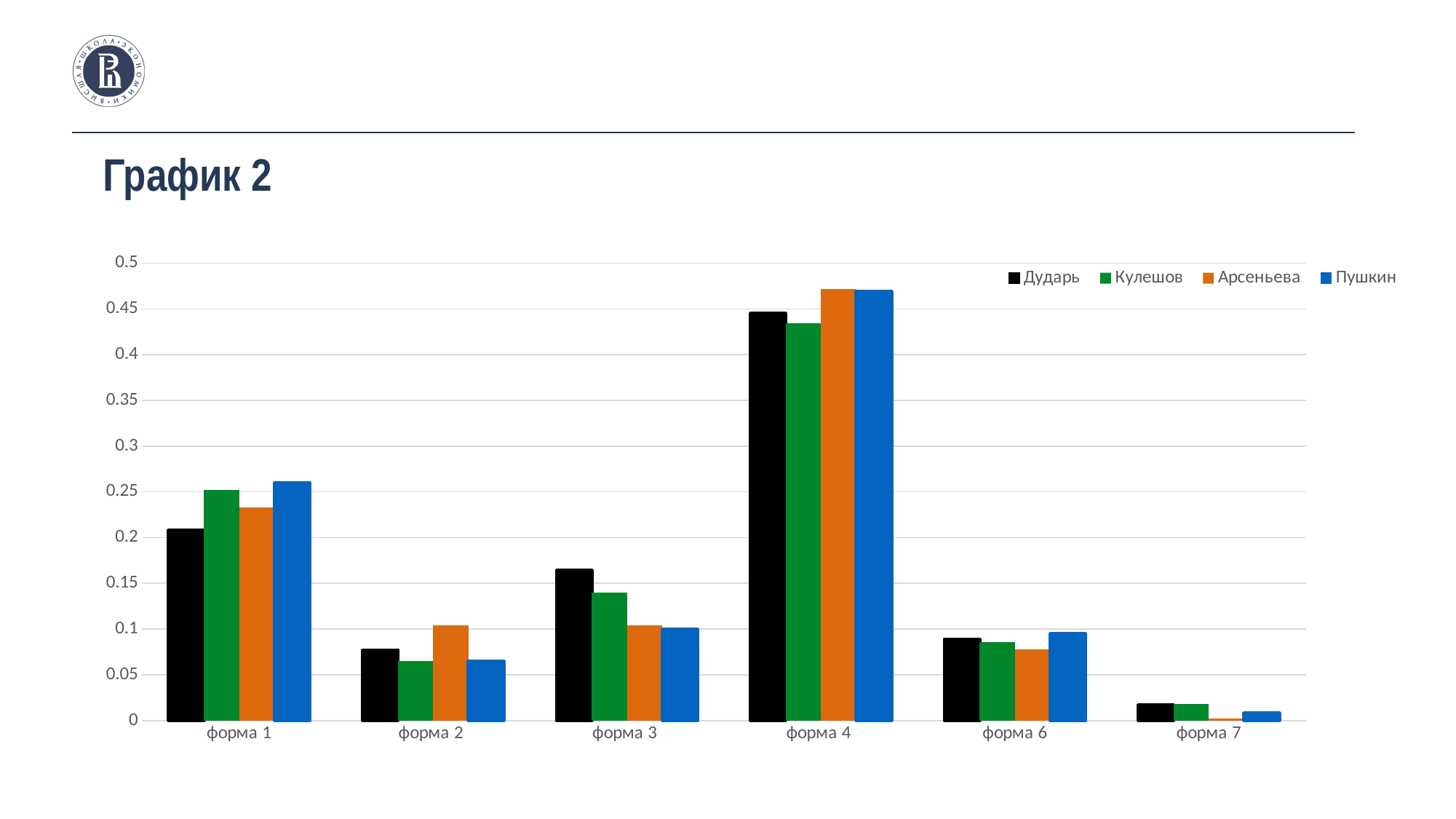
Which category has the lowest value for the Пушкин series? форма 7 Is the value for Кулешов in форма 4 greater or less than 0.45? less Is the value for Дударь in форма 3 greater or less than 0.15? greater What is the title of the slide? График 2 Is the value for Арсеньева in форма 4 greater or less than 0.45? greater In форма 3, which is larger: the value for Дударь or the value for Кулешов? Дударь In форма 1, which is larger: the value for Пушкин or the value for Дударь? Пушкин What kind of chart is shown on the slide? bar chart Which category has the highest value for the Дударь series? форма 4 How many series does the legend list? 4 How many categories are shown on the x axis? 6